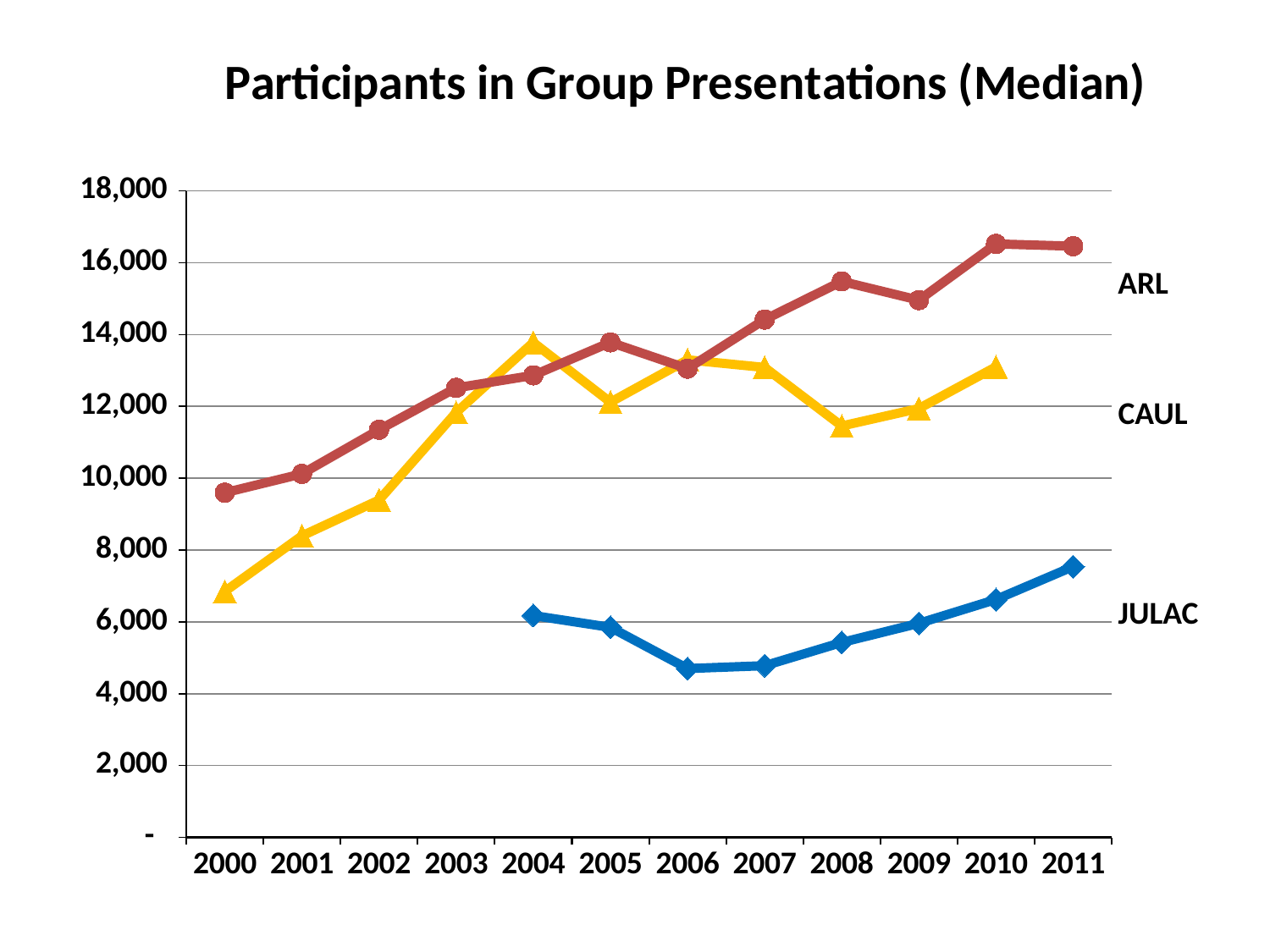
Which series has the highest value in 2011? ARL Is the CAUL value for 2000 greater or less than 8,000? less In 2004, which series is higher, ARL or CAUL? CAUL Is the JULAC value for 2006 greater or less than 6,000? less What is the title of the chart? Participants in Group Presentations (Median) How many years are shown on the x axis? 12 Is the ARL value for 2000 greater or less than 10,000? less What kind of chart is shown on the slide? line chart Which series has the lowest value in 2008? JULAC How many series are plotted on the chart? 3 Does the ARL series generally rise or fall from 2000 to 2011? rise